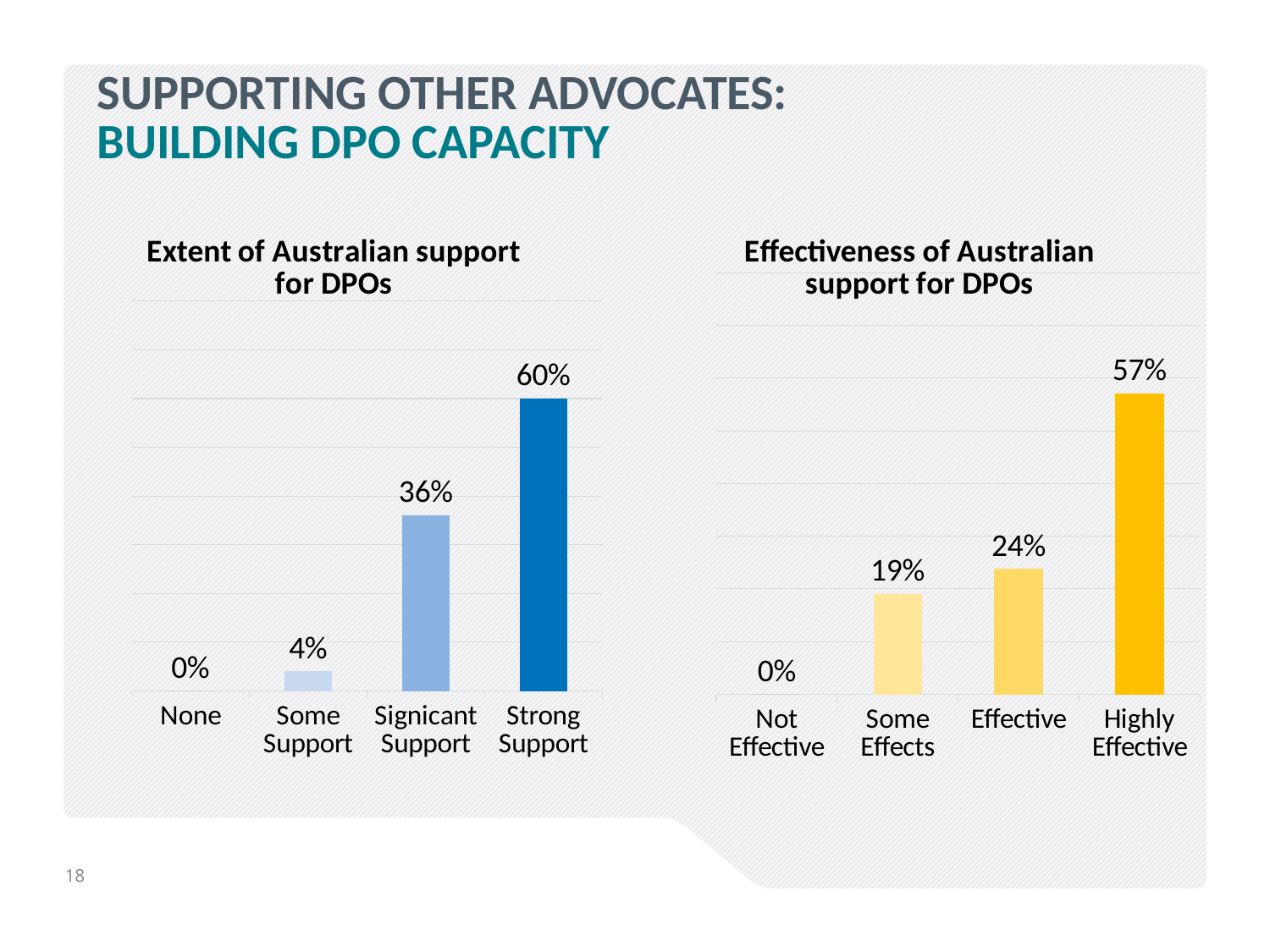
In the 'Effectiveness of Australian support for DPOs' chart, what is the difference between Highly Effective and Effective? 33% In the 'Extent of Australian support for DPOs' chart, what is the difference between Strong Support and Signicant Support? 24% In the 'Effectiveness of Australian support for DPOs' chart, which is larger, Effective or Some Effects? Effective In the 'Extent of Australian support for DPOs' chart, what is the value for Some Support? 4% In the 'Extent of Australian support for DPOs' chart, which category has the highest value? Strong Support In the 'Effectiveness of Australian support for DPOs' chart, do the values rise or fall from left to right? Rise What type of chart is the 'Effectiveness of Australian support for DPOs' chart? Bar chart In the 'Extent of Australian support for DPOs' chart, how many categories are shown? 4 In the 'Effectiveness of Australian support for DPOs' chart, what is the value for Some Effects? 19% In the 'Extent of Australian support for DPOs' chart, which category has the lowest value? None In the 'Extent of Australian support for DPOs' chart, what is the value for Strong Support? 60% In the 'Effectiveness of Australian support for DPOs' chart, what is the value for Highly Effective? 57%